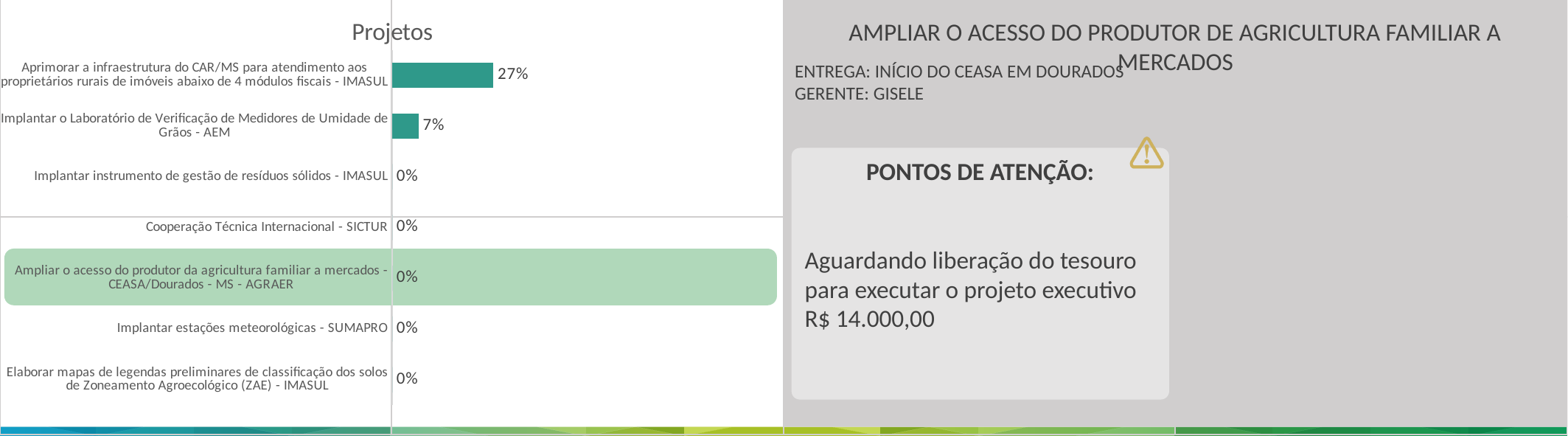
What is the value for "Implantar o Laboratório de Verificação de Medidores de Umidade de Grãos - AEM"? 7% What is the value for "Ampliar o acesso do produtor da agricultura familiar a mercados - CEASA/Dourados - MS - AGRAER"? 0% Which is larger: the value for "Implantar o Laboratório de Verificação de Medidores de Umidade de Grãos - AEM" or for "Cooperação Técnica Internacional - SICTUR"? Implantar o Laboratório de Verificação de Medidores de Umidade de Grãos - AEM What is the difference between the value for the CAR/MS infrastructure project (IMASUL) and the Laboratório de Verificação de Medidores de Umidade de Grãos project (AEM)? 20% What is the value for "Aprimorar a infraestrutura do CAR/MS para atendimento aos proprietários rurais de imóveis abaixo de 4 módulos fiscais - IMASUL"? 27% Which category in the chart is highlighted with a green background? Ampliar o acesso do produtor da agricultura familiar a mercados - CEASA/Dourados - MS - AGRAER Which project has the highest value in the chart? Aprimorar a infraestrutura do CAR/MS para atendimento aos proprietários rurais de imóveis abaixo de 4 módulos fiscais - IMASUL How many projects in the chart have a value of 0%? 5 What is the title of the chart? Projetos What is the value for "Implantar estações meteorológicas - SUMAPRO"? 0% How many projects (categories) are plotted in the chart? 7 What kind of chart is shown on the slide? bar chart